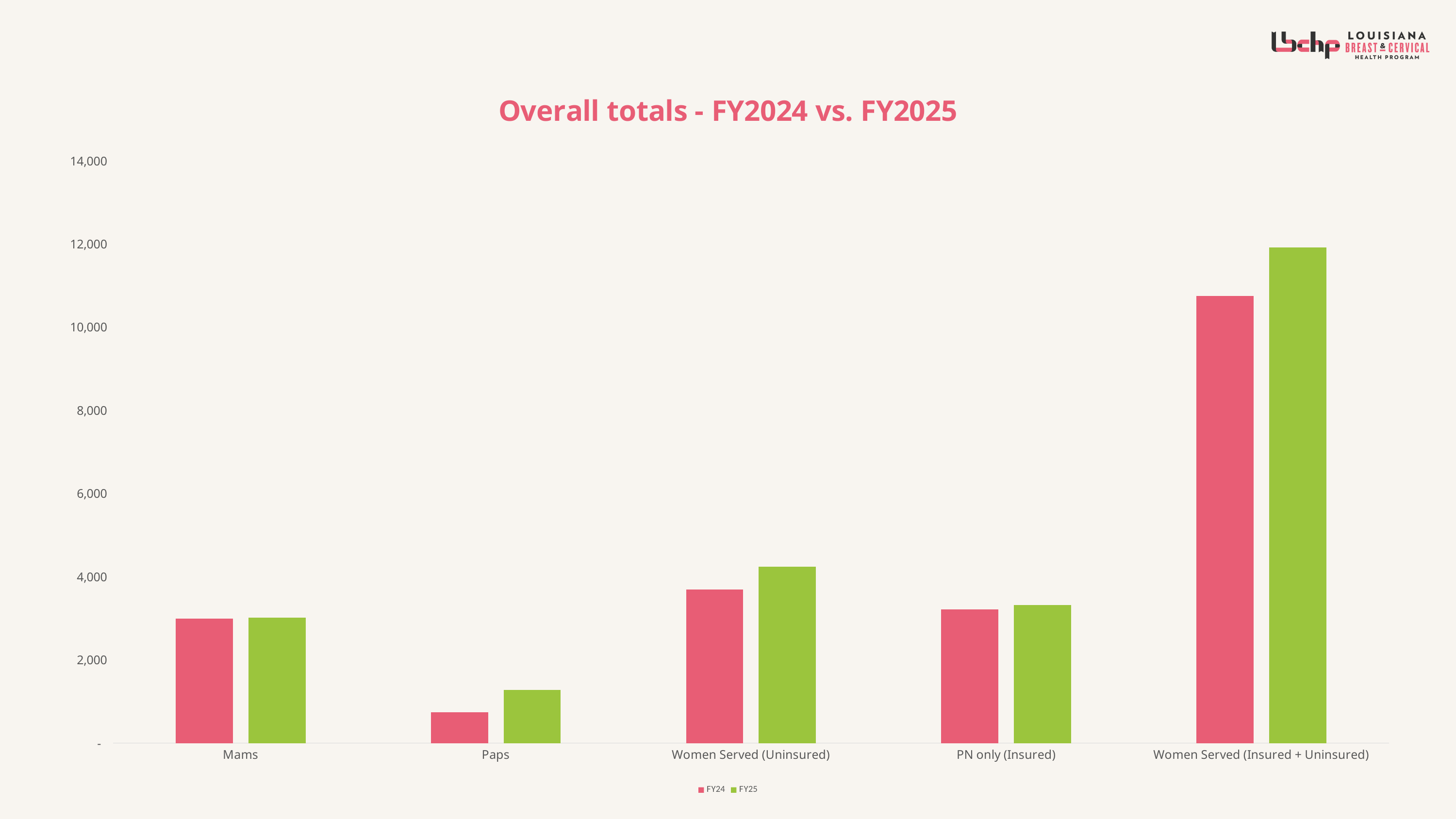
For Paps, which is larger: the FY24 value or the FY25 value? FY25 For Women Served (Uninsured), which is larger: the FY24 value or the FY25 value? FY25 What kind of chart is shown on the slide? Bar chart Which category has the highest FY25 value? Women Served (Insured + Uninsured) Which category has the lowest FY24 value? Paps How many categories are shown on the x axis? 5 What is the title of the chart? Overall totals - FY2024 vs. FY2025 Is the FY24 value for Paps greater or less than 1,000? less How many series does the legend list? 2 Is the FY24 value for Women Served (Insured + Uninsured) greater or less than 10,000? greater Is the FY25 value for Women Served (Uninsured) greater or less than 4,000? greater